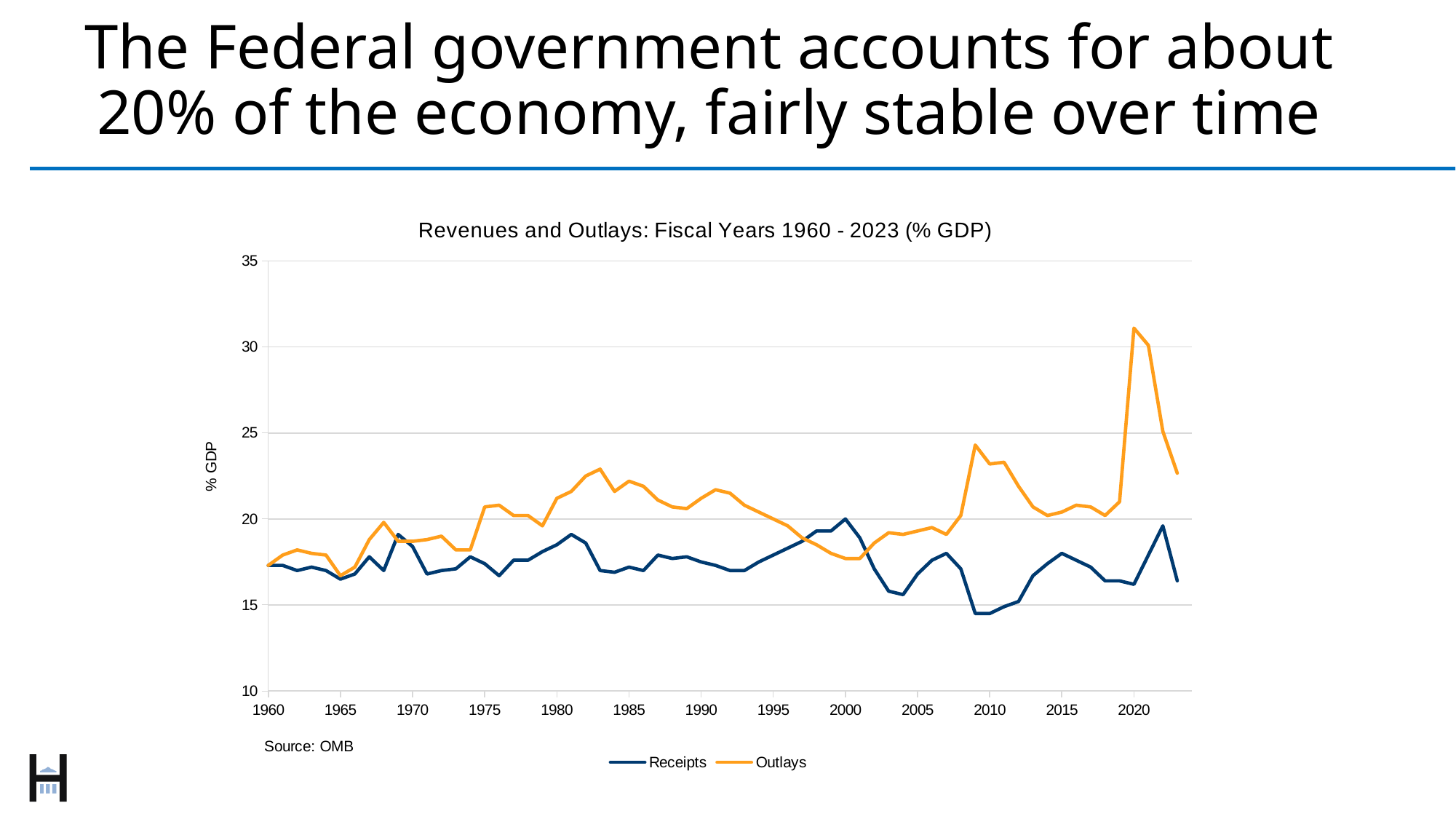
Is the value for Outlays in 2009 greater or less than 20? greater Is the value for Receipts in 2010 greater or less than 15? less Between 2020 and 2023, does the Outlays line rise or fall? Fall In 2000, which series has the higher value, Receipts or Outlays? Receipts In which year does the Outlays line reach its highest value? 2020 What is the label on the chart's vertical axis? % GDP How many series does the chart's legend list? 2 What is the title of the chart? Revenues and Outlays: Fiscal Years 1960 - 2023 (% GDP) Is the value for Receipts in 1985 greater or less than 20? less What kind of chart is shown on the slide? Line chart In 2010, which series has the higher value, Receipts or Outlays? Outlays